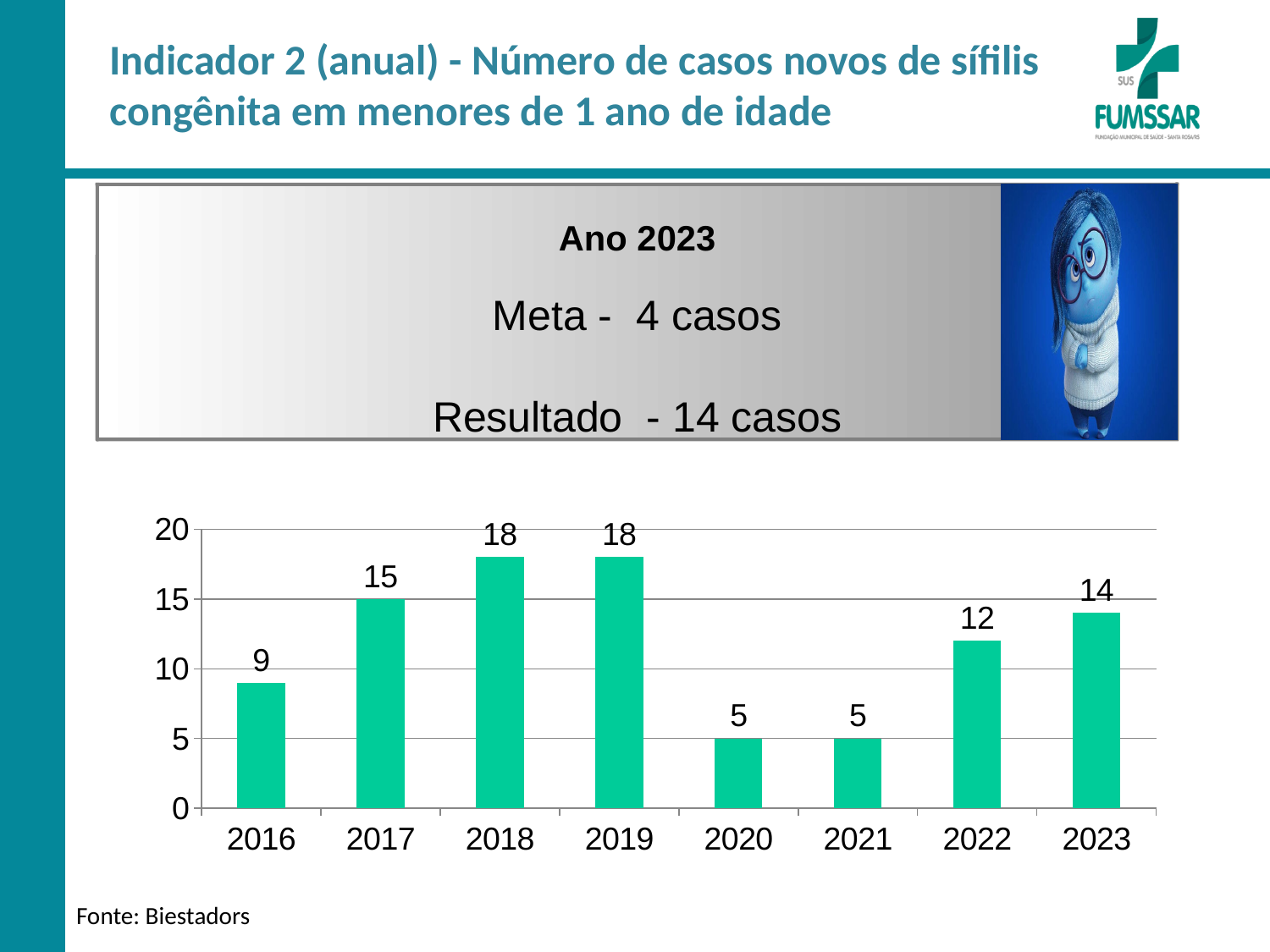
Is the value for 2018 greater or less than 15? greater What is the value for 2022? 12 How many years are shown on the x axis? 8 What is the value for 2016? 9 What is the difference between the values for 2019 and 2020? 13 What is the difference between the values for 2023 and 2022? 2 What kind of chart is shown on the slide? bar chart Do the values rise or fall from 2019 to 2020? fall Which is larger, the value for 2017 or the value for 2023? 2017 Which year has the lowest value? 2020 and 2021 What is the value for 2023? 14 Which years share the highest value? 2018 and 2019